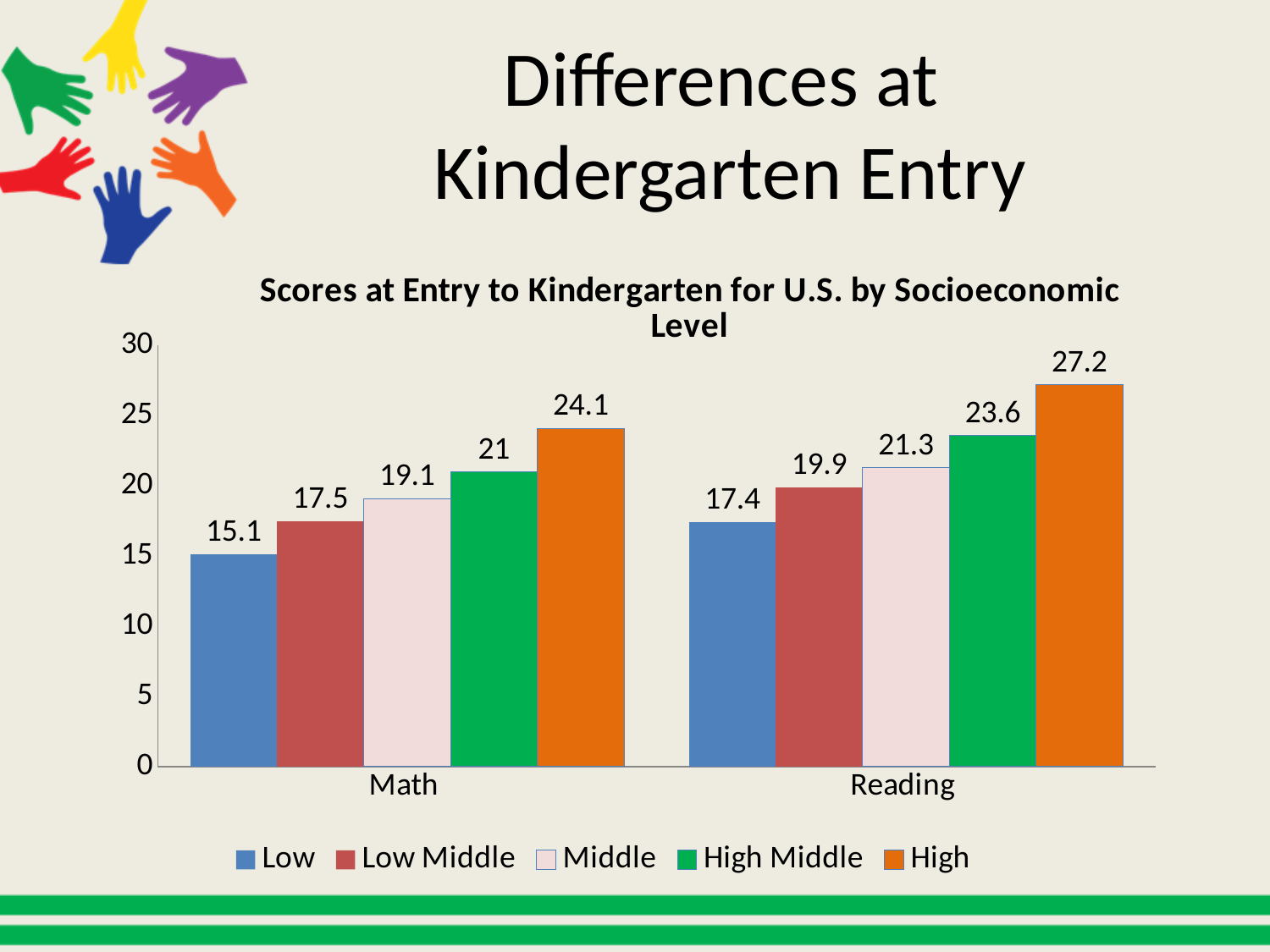
How many socioeconomic levels does the legend list? 5 What is the title of the chart? Scores at Entry to Kindergarten for U.S. by Socioeconomic Level What is the Reading score for the High socioeconomic level? 27.2 What kind of chart is shown on the slide? Bar chart How many subject categories are shown on the x axis? 2 What is the difference between the Reading and Math scores for the High Middle level? 2.6 Which socioeconomic level has the lowest Reading score? Low Which is larger, the Math score for High Middle or the Reading score for Low Middle? Math score for High Middle What is the Math score for the Low socioeconomic level? 15.1 Which socioeconomic level has the highest Math score? High What is the difference between the High and Low Reading scores? 9.8 What is the Reading score for the Middle socioeconomic level? 21.3